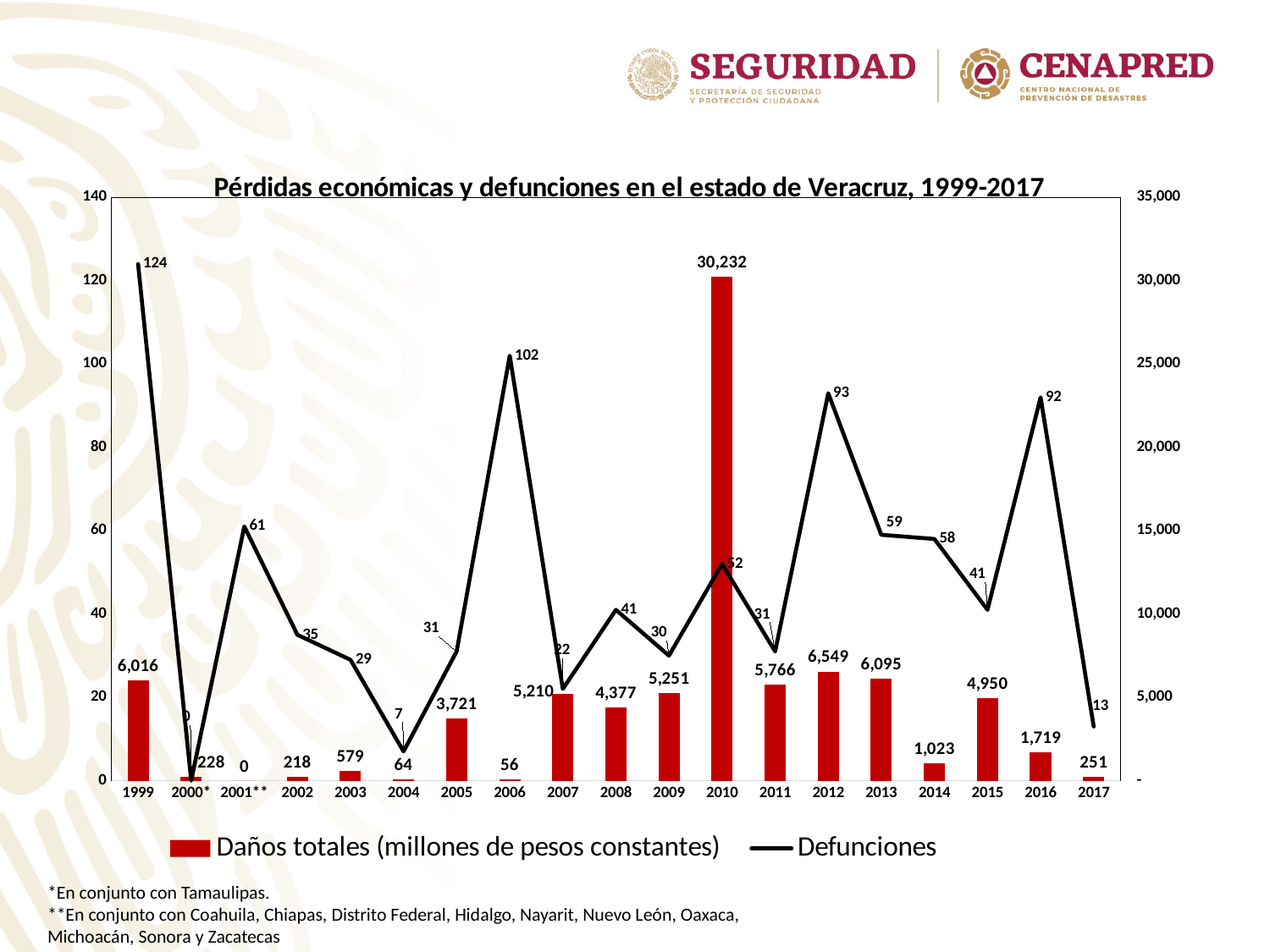
What is the value of Daños totales (millones de pesos constantes) for 2015? 4,950 Which year has the highest number of Defunciones? 1999 How many series does the legend list? 2 What is the difference in Defunciones between 1999 and 2017? 111 What type of chart is shown on the slide? Combined bar and line chart How many years are shown on the x axis? 19 What is the title of the chart? Pérdidas económicas y defunciones en el estado de Veracruz, 1999-2017 Which year has more Defunciones, 2012 or 2016? 2012 How many Defunciones are recorded for 2006? 102 Which year has the lowest value of Daños totales (millones de pesos constantes)? 2001** What is the difference in Daños totales (millones de pesos constantes) between 2012 and 2013? 454 What is the value of Daños totales (millones de pesos constantes) for 2010? 30,232